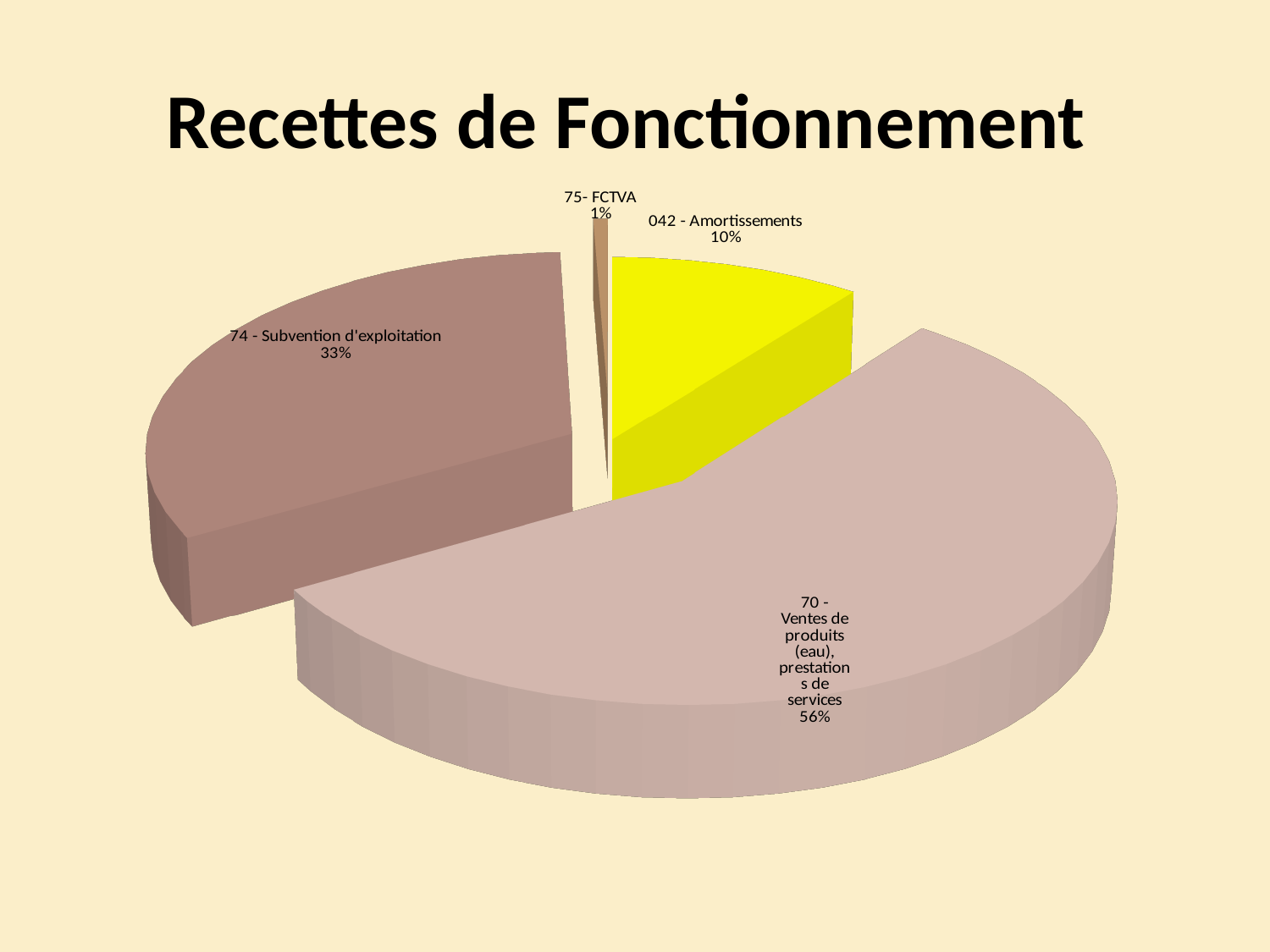
What share of the pie does '70 - Ventes de produits (eau), prestations de services' represent? 56% What share of the pie does '75- FCTVA' represent? 1% What share of the pie does '74 - Subvention d'exploitation' represent? 33% Which category has the smallest slice of the pie? 75- FCTVA Which category has the largest slice of the pie? 70 - Ventes de produits (eau), prestations de services Which is larger: the share for '042 - Amortissements' or the share for '75- FCTVA'? 042 - Amortissements What colour is the slice for '042 - Amortissements'? Yellow What kind of chart is shown on the slide? Pie chart What is the title of the chart? Recettes de Fonctionnement What is the difference in percentage points between '70 - Ventes de produits (eau), prestations de services' and '74 - Subvention d'exploitation'? 23 percentage points How many slices does the pie chart have? 4